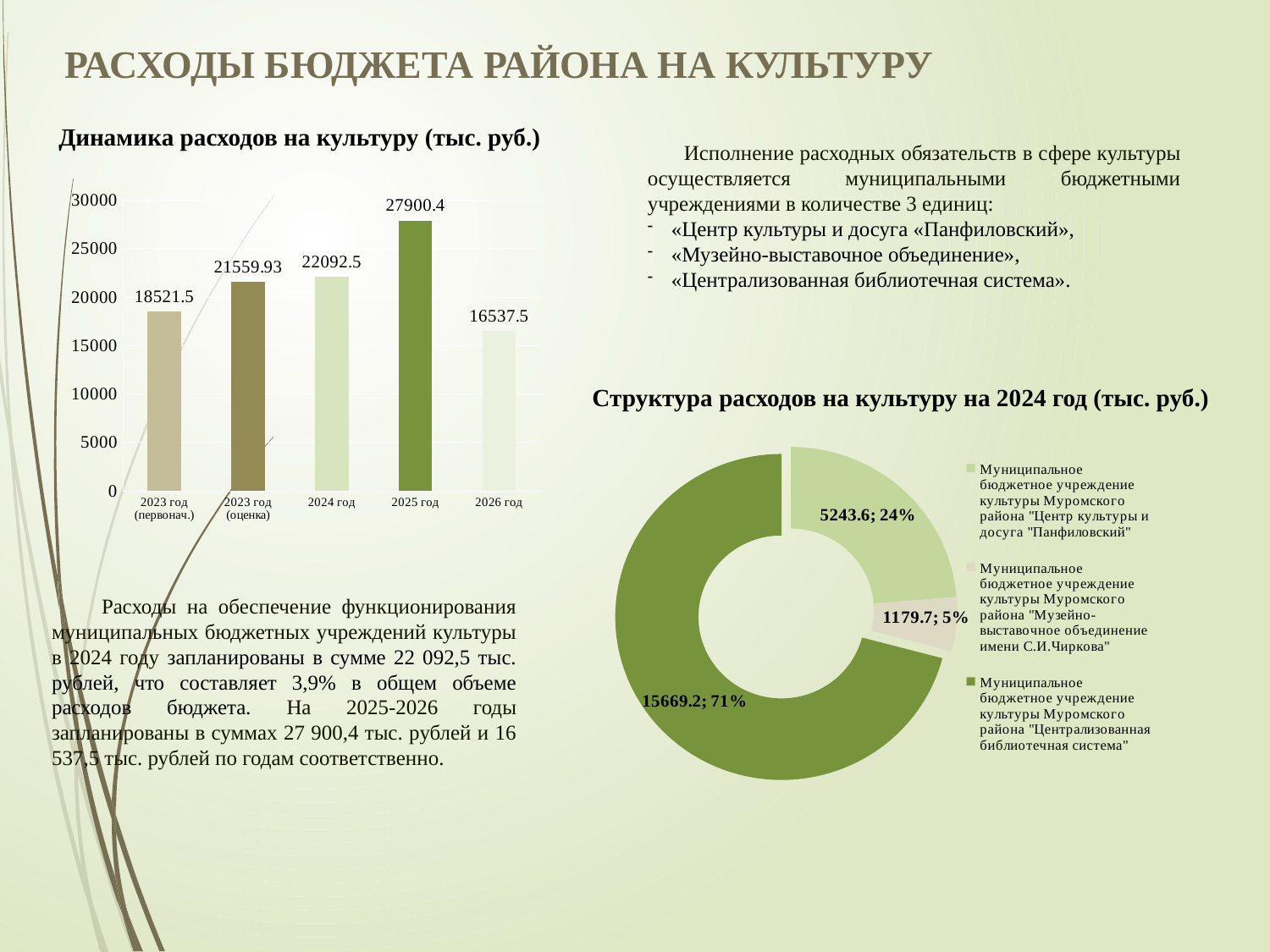
In the chart "Структура расходов на культуру на 2024 год (тыс. руб.)", what is the value for "Музейно-выставочное объединение имени С.И.Чиркова"? 1179.7 In the chart "Динамика расходов на культуру (тыс. руб.)", what is the difference between the values for 2025 год and 2026 год? 11362.9 In the chart "Структура расходов на культуру на 2024 год (тыс. руб.)", which institution has the smallest slice? Музейно-выставочное объединение имени С.И.Чиркова How many entries does the legend of the chart "Структура расходов на культуру на 2024 год (тыс. руб.)" list? 3 What kind of chart is "Динамика расходов на культуру (тыс. руб.)"? Bar chart In the chart "Динамика расходов на культуру (тыс. руб.)", which is larger: the value for 2024 год or for 2023 год (первонач.)? 2024 год In the chart "Динамика расходов на культуру (тыс. руб.)", which year has the highest value? 2025 год In the chart "Структура расходов на культуру на 2024 год (тыс. руб.)", what share does the "Централизованная библиотечная система" slice have? 71% In the chart "Динамика расходов на культуру (тыс. руб.)", how many bars are plotted? 5 In the chart "Динамика расходов на культуру (тыс. руб.)", what is the value for 2025 год? 27900.4 In the chart "Динамика расходов на культуру (тыс. руб.)", what is the value for 2023 год (оценка)? 21559.93 In the chart "Динамика расходов на культуру (тыс. руб.)", which category has the lowest value? 2026 год